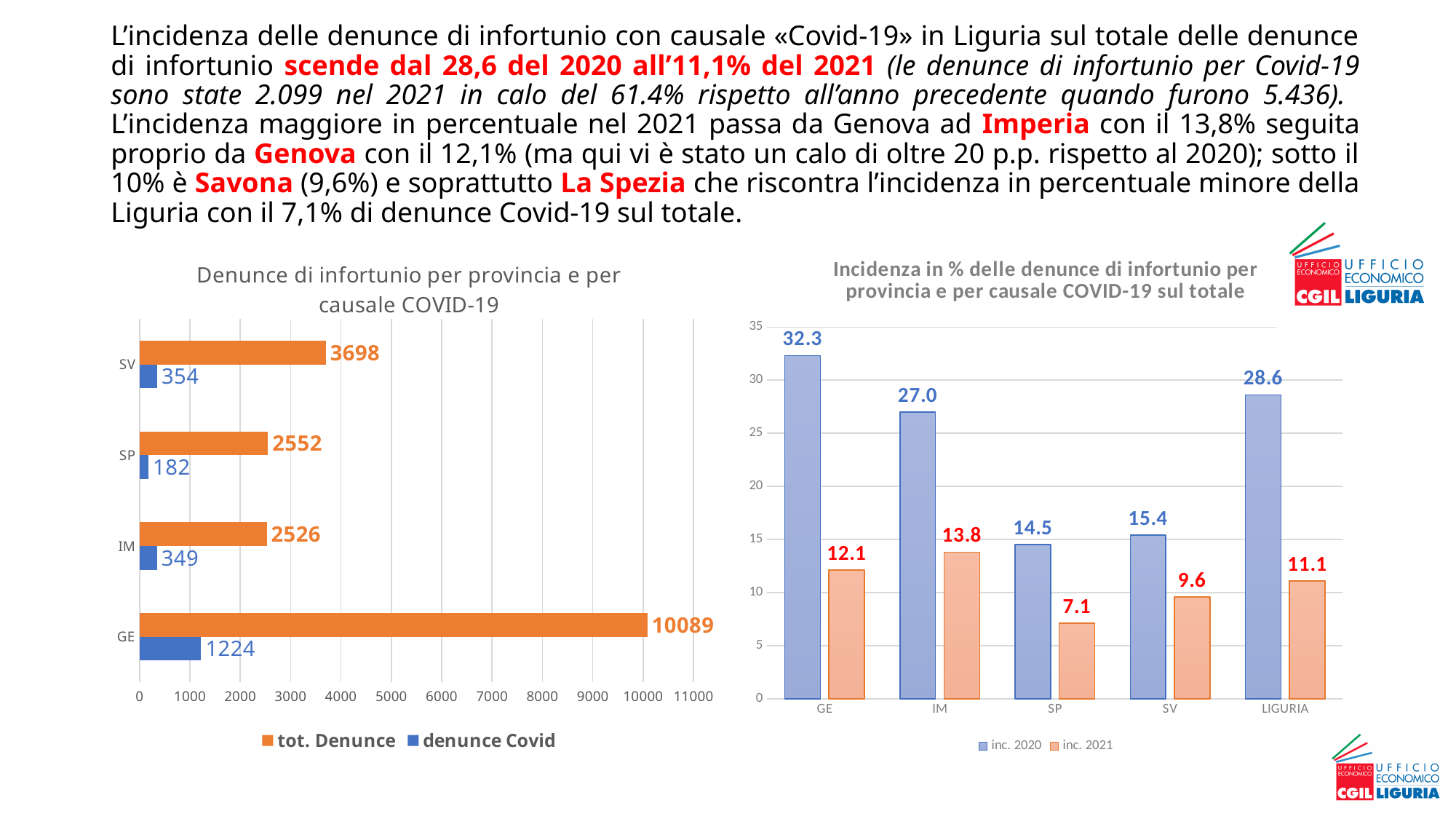
In the left chart 'Denunce di infortunio per provincia e per causale COVID-19', what is the difference between tot. Denunce for SV and tot. Denunce for SP? 1146 In the right chart 'Incidenza in % delle denunce di infortunio per provincia e per causale COVID-19 sul totale', what is the inc. 2021 value for LIGURIA? 11.1 In the left chart 'Denunce di infortunio per provincia e per causale COVID-19', what is the value of denunce Covid for SP? 182 In the right chart 'Incidenza in % delle denunce di infortunio per provincia e per causale COVID-19 sul totale', how many categories are shown on the x axis? 5 In the right chart 'Incidenza in % delle denunce di infortunio per provincia e per causale COVID-19 sul totale', what is the inc. 2020 value for IM? 27.0 In the left chart 'Denunce di infortunio per provincia e per causale COVID-19', which province has the highest tot. Denunce? GE In the left chart 'Denunce di infortunio per provincia e per causale COVID-19', how many series does the legend list? 2 In the left chart 'Denunce di infortunio per provincia e per causale COVID-19', what kind of chart is it? bar chart In the right chart 'Incidenza in % delle denunce di infortunio per provincia e per causale COVID-19 sul totale', which category has the highest inc. 2021 value? IM In the left chart 'Denunce di infortunio per provincia e per causale COVID-19', which province has the lowest denunce Covid? SP In the right chart 'Incidenza in % delle denunce di infortunio per provincia e per causale COVID-19 sul totale', what is the difference between inc. 2020 and inc. 2021 for GE? 20.2 In the left chart 'Denunce di infortunio per provincia e per causale COVID-19', what is the value of tot. Denunce for GE? 10089